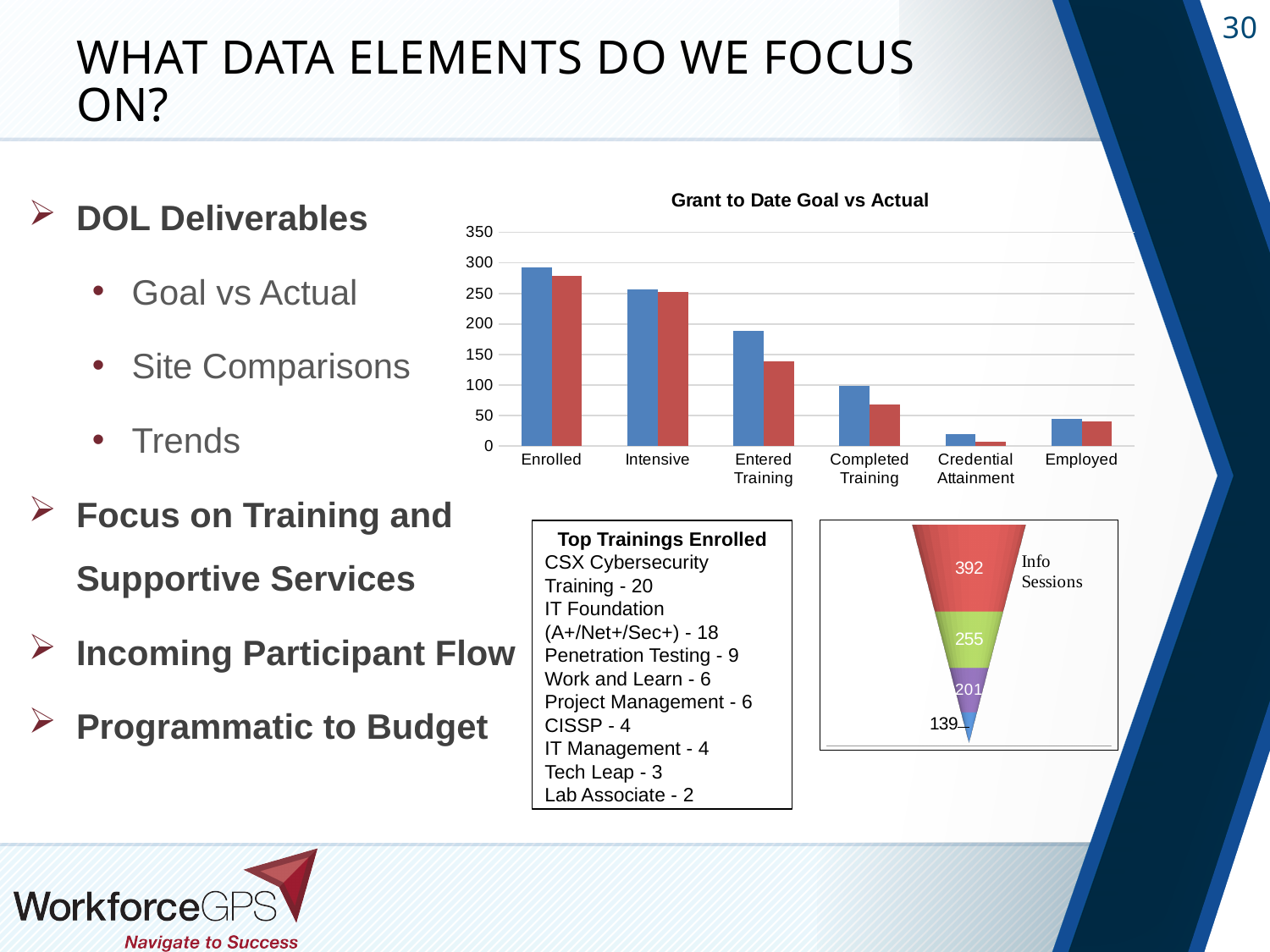
What kind of chart is the 'Grant to Date Goal vs Actual' chart? bar chart In the 'Grant to Date Goal vs Actual' chart, which category has taller bars, Completed Training or Employed? Completed Training In the 'Grant to Date Goal vs Actual' chart, is the blue bar for Enrolled greater or less than 250? greater How many categories are shown on the x axis of the 'Grant to Date Goal vs Actual' chart? 6 In the funnel chart at the bottom right, what is the value of the top segment labelled Info Sessions? 392 In the 'Grant to Date Goal vs Actual' chart, which is larger for Entered Training, the blue bar or the red bar? the blue bar In the 'Grant to Date Goal vs Actual' chart, is the blue bar for Credential Attainment greater or less than 50? less In the funnel chart at the bottom right, what is the difference between the largest segment value and the smallest segment value? 253 In the 'Grant to Date Goal vs Actual' chart, is the blue bar for Entered Training greater or less than 150? greater In the 'Grant to Date Goal vs Actual' chart, which category has the shortest bars? Credential Attainment In the 'Grant to Date Goal vs Actual' chart, which category has the tallest bars? Enrolled